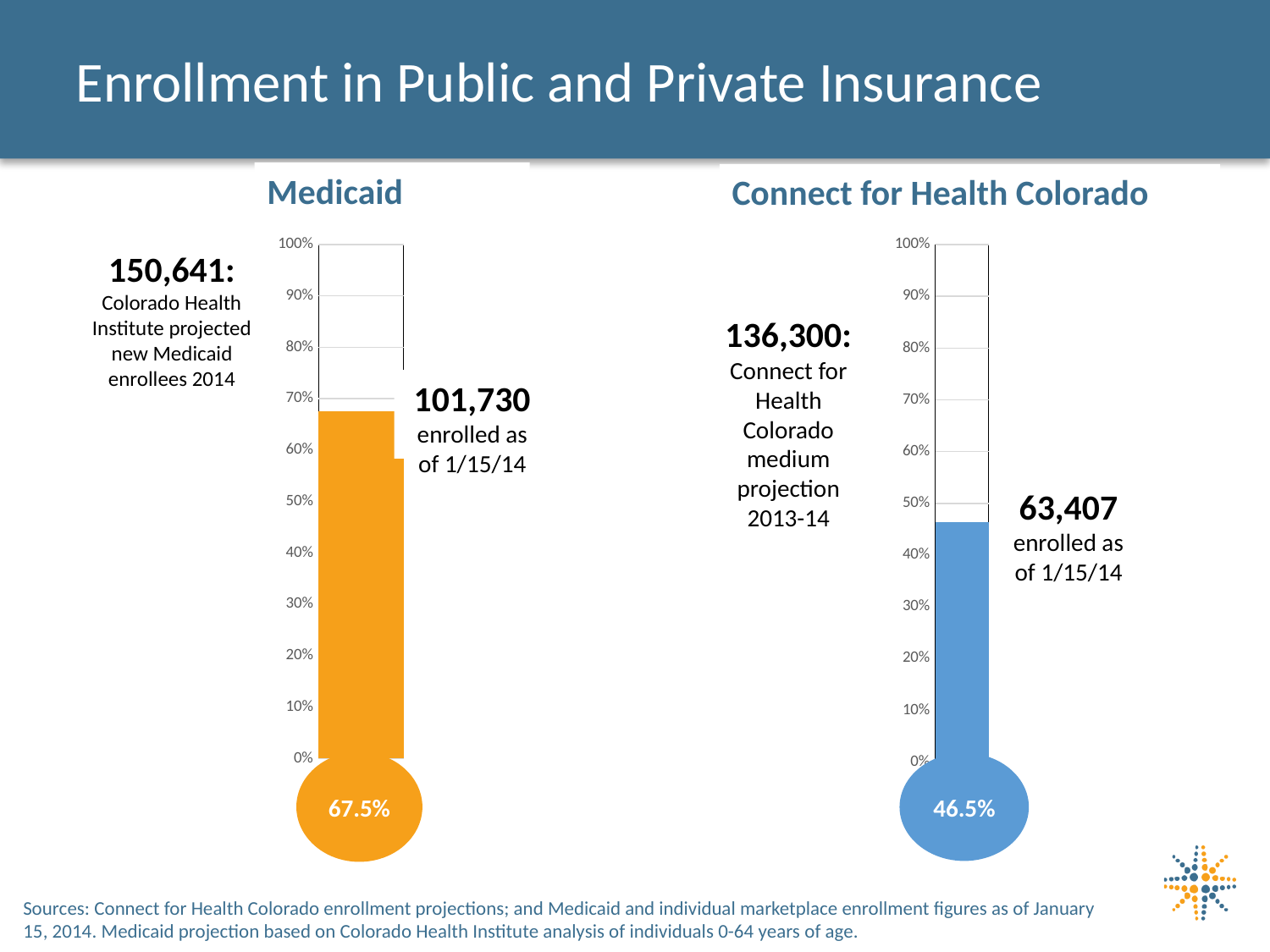
On the Connect for Health Colorado chart, how many people were enrolled as of 1/15/14? 63,407 On the Medicaid chart, what is the Colorado Health Institute projected number of new Medicaid enrollees for 2014? 150,641 On the Medicaid chart, what percentage of the projected enrollment has been reached? 67.5% Which chart shows the higher percentage of its projection reached, Medicaid or Connect for Health Colorado? Medicaid On the Medicaid chart, how many people were enrolled as of 1/15/14? 101,730 What is the difference in percentage points between the Medicaid fill level (67.5%) and the Connect for Health Colorado fill level (46.5%)? 21 percentage points What colour is the filled bar on the Connect for Health Colorado chart? Blue On the Connect for Health Colorado chart, what percentage of the projected enrollment has been reached? 46.5% On the Medicaid chart, is the filled bar greater or less than 60%? greater What kind of chart is used on this slide to show enrollment progress? Bar chart (thermometer-style) On the Connect for Health Colorado chart, what is the medium projection for 2013-14? 136,300 On the Connect for Health Colorado chart, is the filled bar greater or less than 50%? less